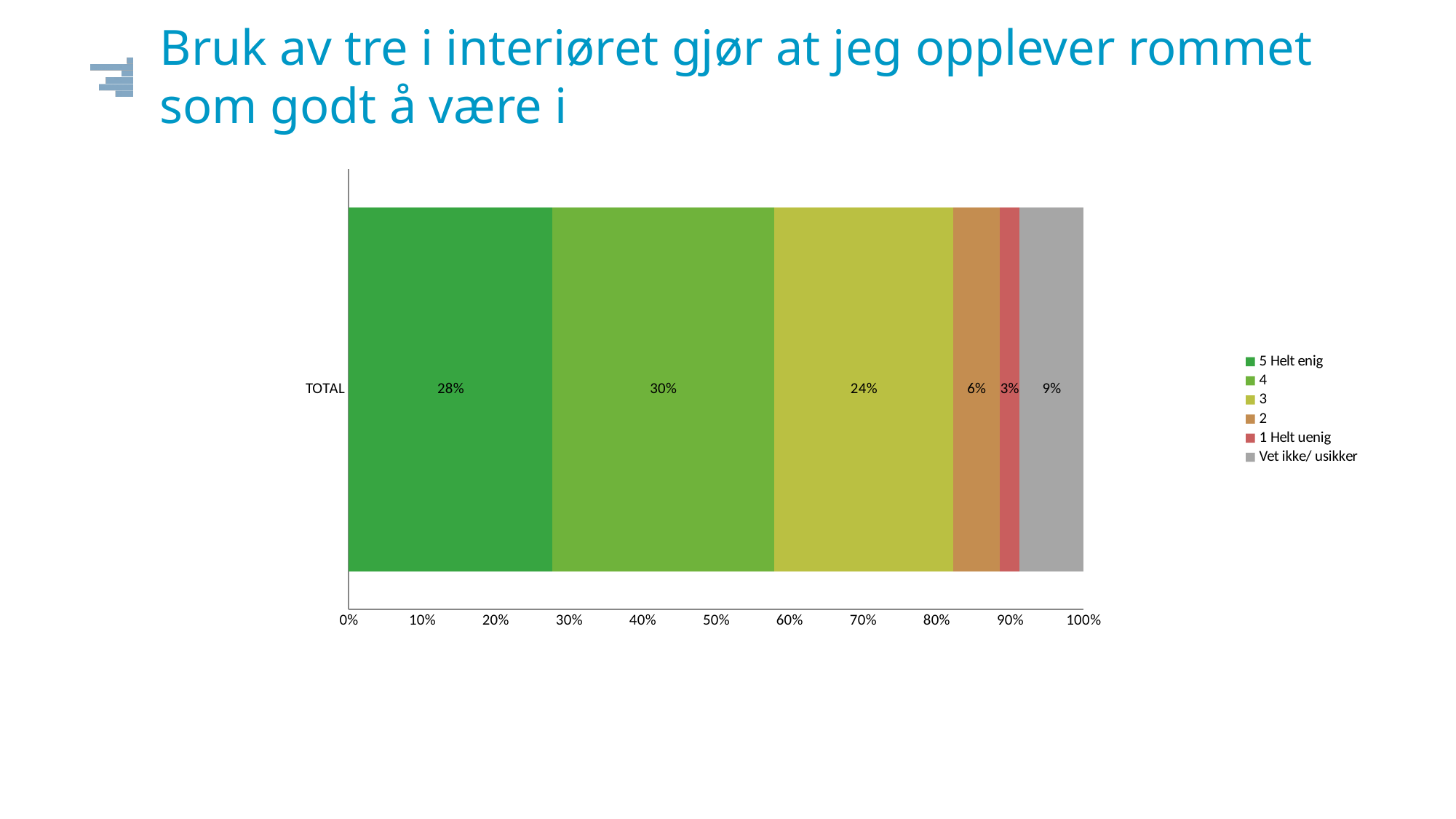
What percentage of respondents answered "Vet ikke/ usikker"? 9% What is the difference between the share for "4" and the share for "2"? 24% Which response category has the largest share? 4 How many series does the legend list? 6 What is the total of the stacked bar for TOTAL? 100% What percentage of respondents answered "5 Helt enig"? 28% What percentage of respondents answered "4"? 30% What percentage of respondents answered "1 Helt uenig"? 3% Which is larger, the share for "5 Helt enig" or the share for "3"? 5 Helt enig What percentage of respondents answered "3"? 24% What kind of chart is shown on the slide? Stacked bar chart Which response category has the smallest share? 1 Helt uenig